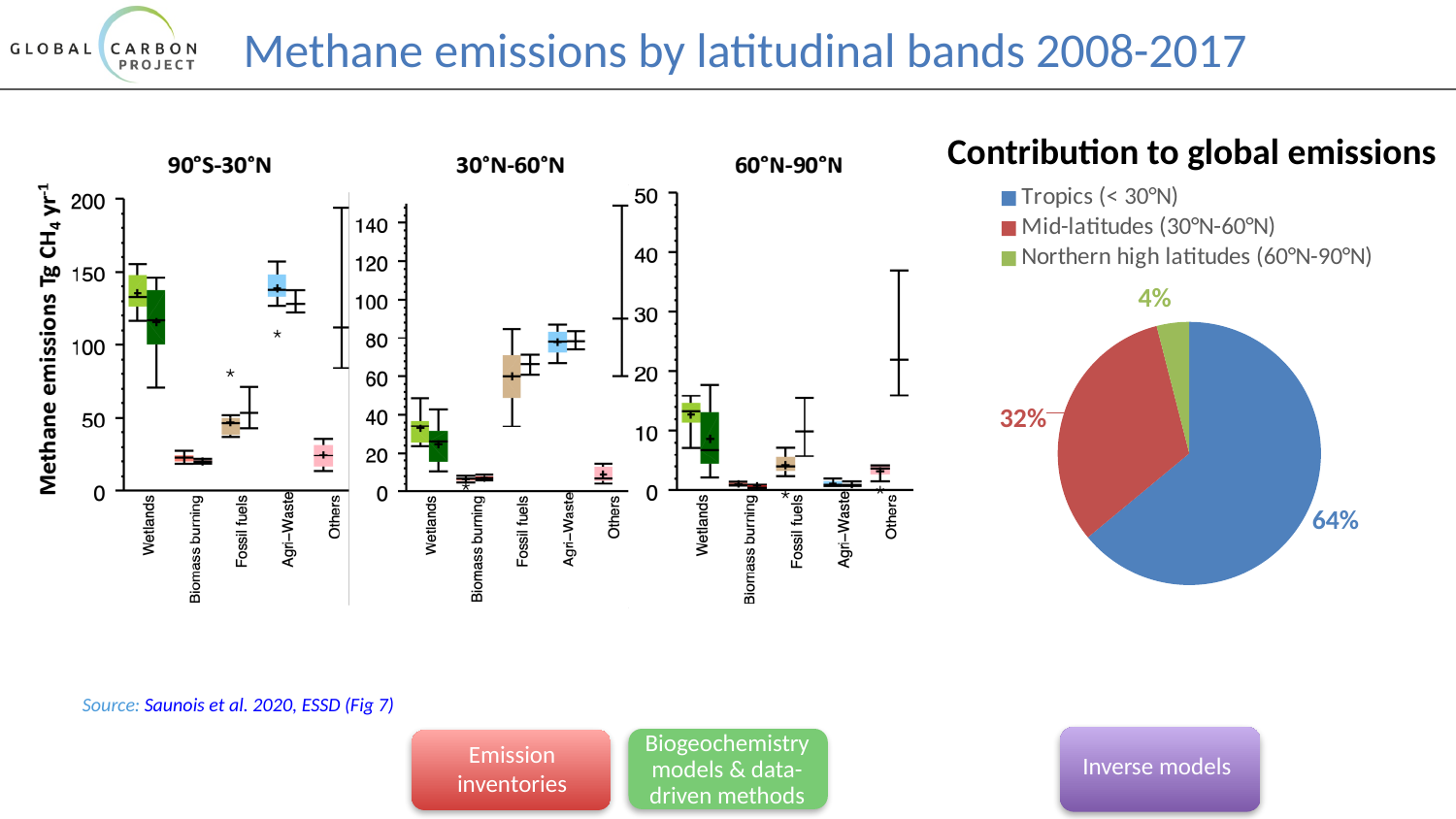
What kind of chart is the 'Contribution to global emissions' chart? Pie chart How many source categories are shown on the x axis of the 60°N-90°N chart? 5 In the 30°N-60°N chart, is the value for Biomass burning greater or less than 20? less In the 'Contribution to global emissions' pie chart, what share is attributed to Tropics (< 30°N)? 64% In the 'Contribution to global emissions' pie chart, which latitudinal band has the largest share? Tropics (< 30°N) In the 90°S-30°N chart, is the value for Biomass burning greater or less than 50? less In the 'Contribution to global emissions' pie chart, which latitudinal band has the smallest share? Northern high latitudes (60°N-90°N) In the 'Contribution to global emissions' pie chart, how many percentage points larger is the Tropics share than the Mid-latitudes share? 32 percentage points In the 90°S-30°N chart, is the value for Agri-Waste greater or less than 100? greater In the 'Contribution to global emissions' pie chart, what share is attributed to Mid-latitudes (30°N-60°N)? 32% In the 'Contribution to global emissions' pie chart, what share is attributed to Northern high latitudes (60°N-90°N)? 4% How many slices does the 'Contribution to global emissions' pie chart have? 3